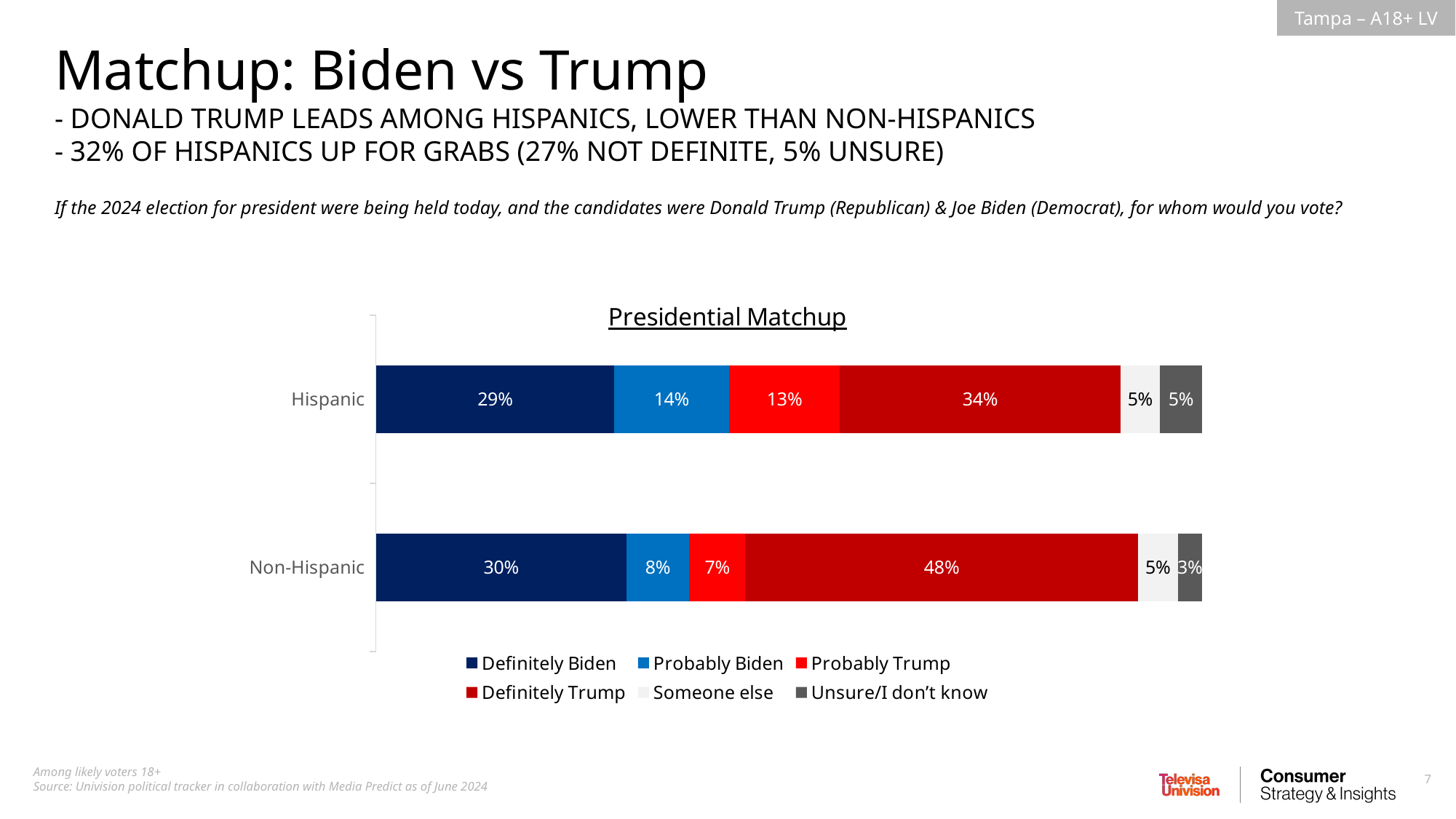
What is the difference in the Definitely Trump share between Non-Hispanic and Hispanic respondents? 14 percentage points How many groups (categories) are shown on the chart? 2 Which group has the higher Definitely Trump share, Hispanic or Non-Hispanic? Non-Hispanic What is the title of the chart? Presidential Matchup What is the difference between Probably Trump for Hispanic and Non-Hispanic respondents? 6 percentage points What percentage of Non-Hispanic respondents said Definitely Biden? 30% What kind of chart is shown on the slide? Stacked bar chart How many series does the legend list? 6 Which response category is the largest for Non-Hispanic respondents? Definitely Trump What percentage of Hispanic respondents said Definitely Trump? 34% What percentage of Non-Hispanic respondents said Unsure/I don't know? 3% What percentage of Hispanic respondents said Probably Biden? 14%